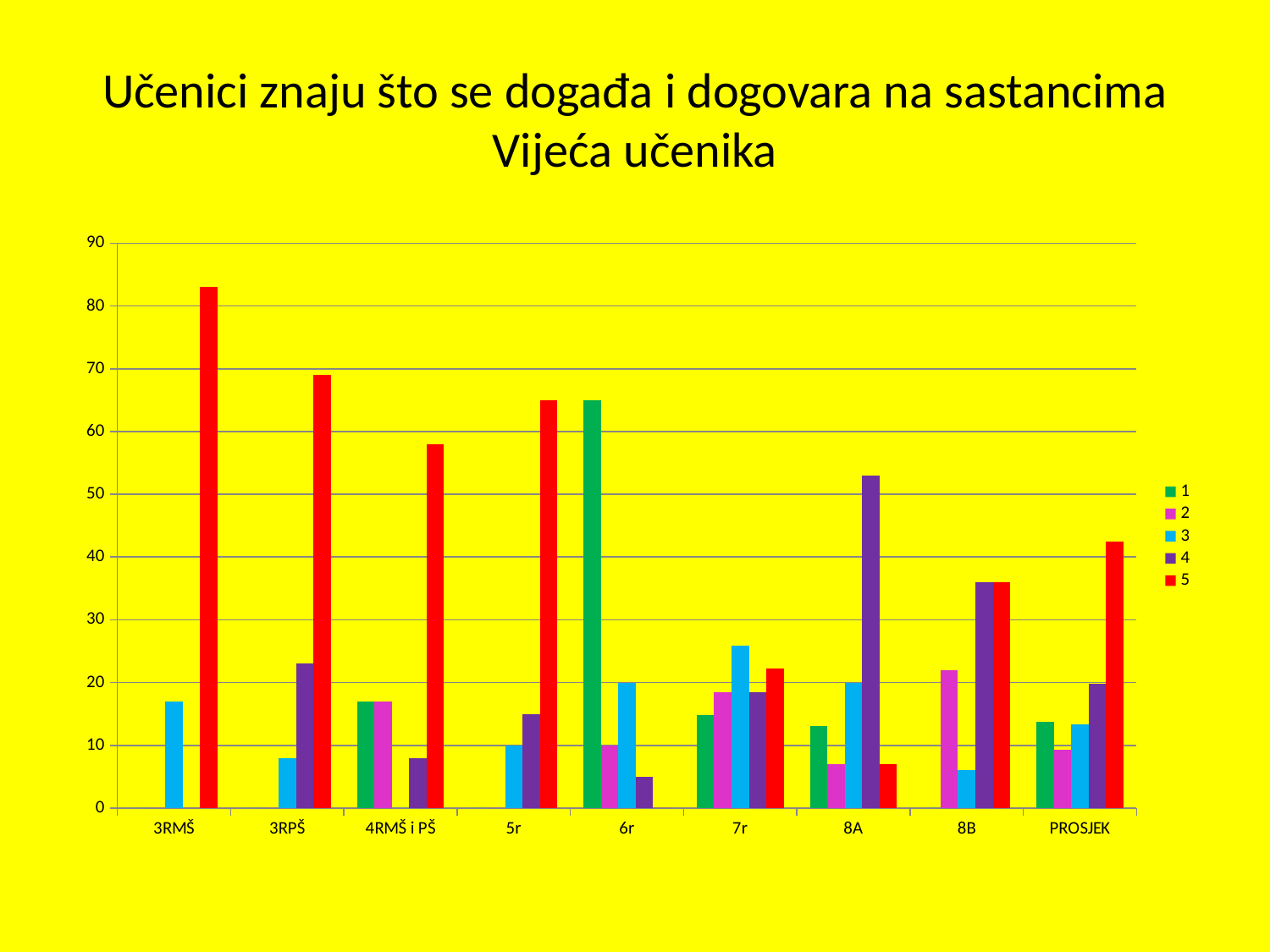
How many categories are shown on the x axis? 9 Is the value for series 4 in 8A greater or less than 50? greater Is the value for series 5 in 3RMŠ greater or less than 80? greater In the 6r category, which series has the highest bar? 1 What kind of chart is shown on the slide? bar chart In the 7r category, which is larger: series 3 or series 1? series 3 Which is larger: the series 5 value for 3RPŠ or the series 5 value for 4RMŠ i PŠ? 3RPŠ Which category has the highest bar for series 5? 3RMŠ Is the value for series 5 in PROSJEK greater or less than 30? greater What entries are listed in the legend? 1, 2, 3, 4, 5 How many series does the legend list? 5